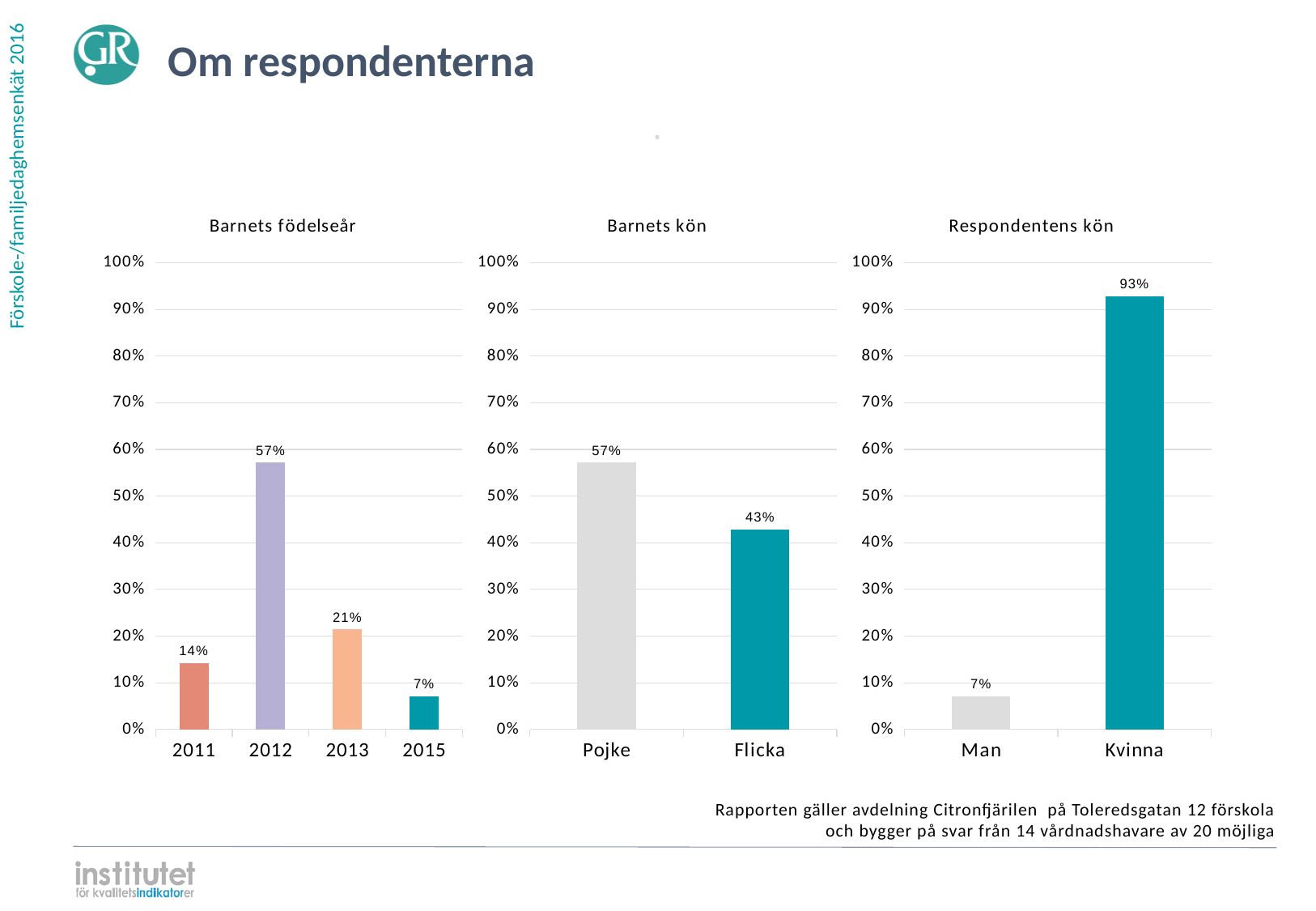
In the 'Respondentens kön' chart, what is the value for Man? 7% In the 'Barnets födelseår' chart, which birth year has the lowest value? 2015 In the 'Respondentens kön' chart, is the value for Kvinna greater or less than 90%? greater In the 'Barnets födelseår' chart, what is the value for 2012? 57% In the 'Barnets födelseår' chart, what is the difference between the values for 2013 and 2011? 7% What is the title of the chart on the right of the slide? Respondentens kön In the 'Barnets födelseår' chart, how many birth-year categories are shown? 4 What kind of chart is the 'Barnets kön' chart? Bar chart In the 'Barnets kön' chart, what is the value for Flicka? 43% In the 'Barnets kön' chart, what is the difference between Pojke and Flicka? 14% In the 'Respondentens kön' chart, what is the value for Kvinna? 93% In the 'Barnets kön' chart, which is larger, Pojke or Flicka? Pojke